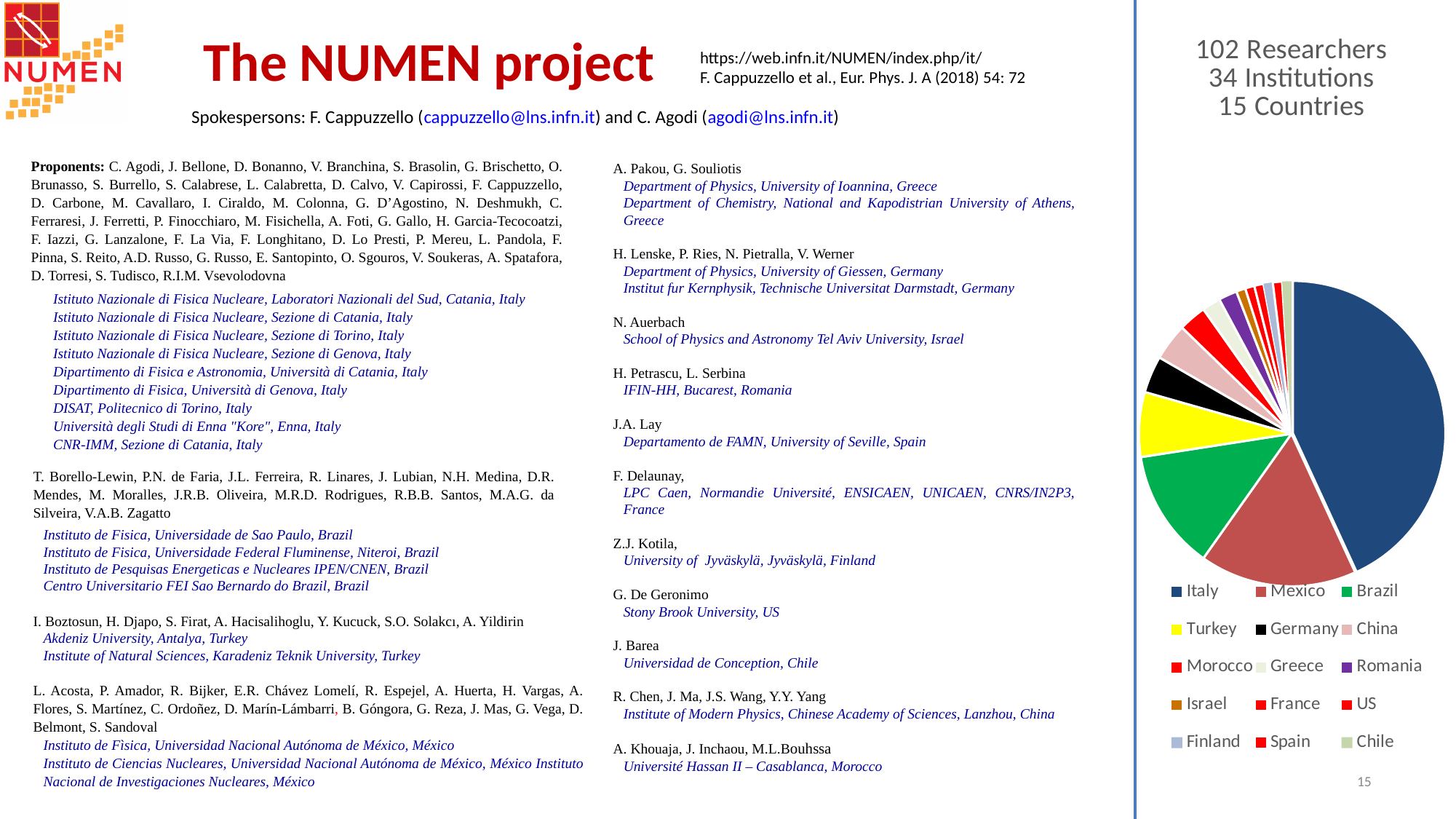
What colour is used for Brazil in the pie chart legend? green Which country has the second-largest slice in the pie chart? Mexico In the pie chart, which slice is larger, Mexico or Brazil? Mexico In the pie chart, which slice is larger, Italy or Mexico? Italy What colour is used for Italy in the pie chart legend? dark blue How many countries does the legend of the pie chart list? 15 In the pie chart, which slice is larger, Mexico or Turkey? Mexico What kind of chart is shown on the right side of the slide? pie chart Which country has the largest slice in the pie chart? Italy